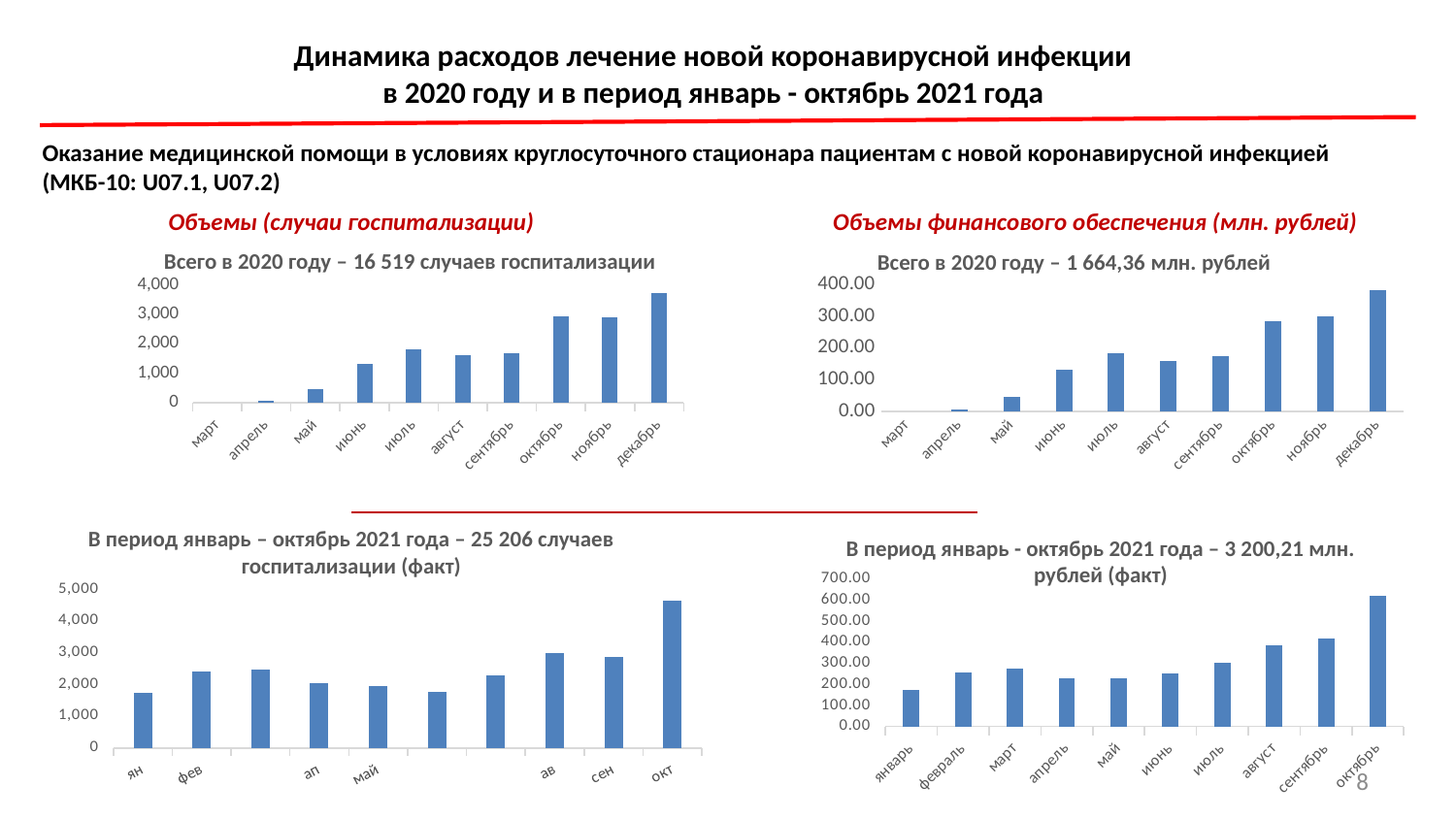
In the bottom-right chart (январь - октябрь 2021 financing, млн. рублей), is the value for январь greater or less than 200.00? less In the top-right chart (2020 financing, млн. рублей), is the value for октябрь greater or less than 200.00? greater How many months are shown on the x axis of the top-right chart (Всего в 2020 году – 1 664,36 млн. рублей)? 10 In the top-left chart (2020 hospitalization cases), which month has the highest value? декабрь In the top-right chart (2020 financing, млн. рублей), which month has the highest value? декабрь What type of chart is the top-left chart (Всего в 2020 году – 16 519 случаев госпитализации)? bar chart In the bottom-left chart (январь – октябрь 2021 hospitalization cases), is the value for окт greater or less than 4,000? greater In the bottom-left chart (январь – октябрь 2021 hospitalization cases), which month has the highest value? окт What total is stated in the title of the bottom-right chart for January–October 2021? 3 200,21 млн. рублей